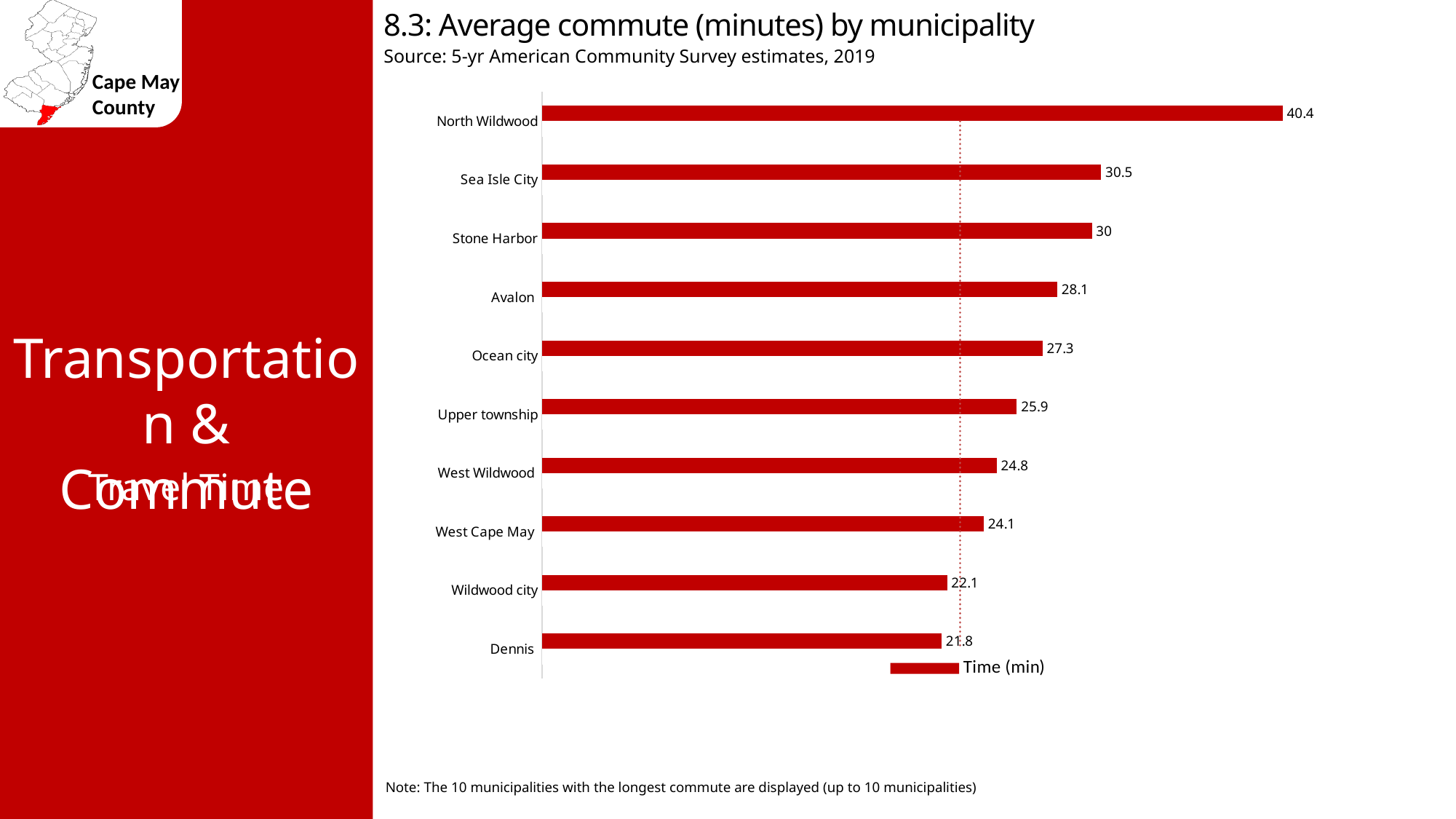
Which has a longer average commute, Ocean city or West Wildwood? Ocean city How many municipalities are shown on the chart? 10 What is the name of the series shown in the legend? Time (min) What is the difference in average commute time between Avalon and Dennis? 6.3 What kind of chart is shown on the slide? Bar chart What is the average commute time for North Wildwood? 40.4 What is the difference in average commute time between North Wildwood and Sea Isle City? 9.9 How many series does the legend list? 1 Which municipality has the shortest average commute shown on the chart? Dennis Which municipality has the longest average commute? North Wildwood What is the average commute time for Upper township? 25.9 What is the average commute time for Stone Harbor? 30